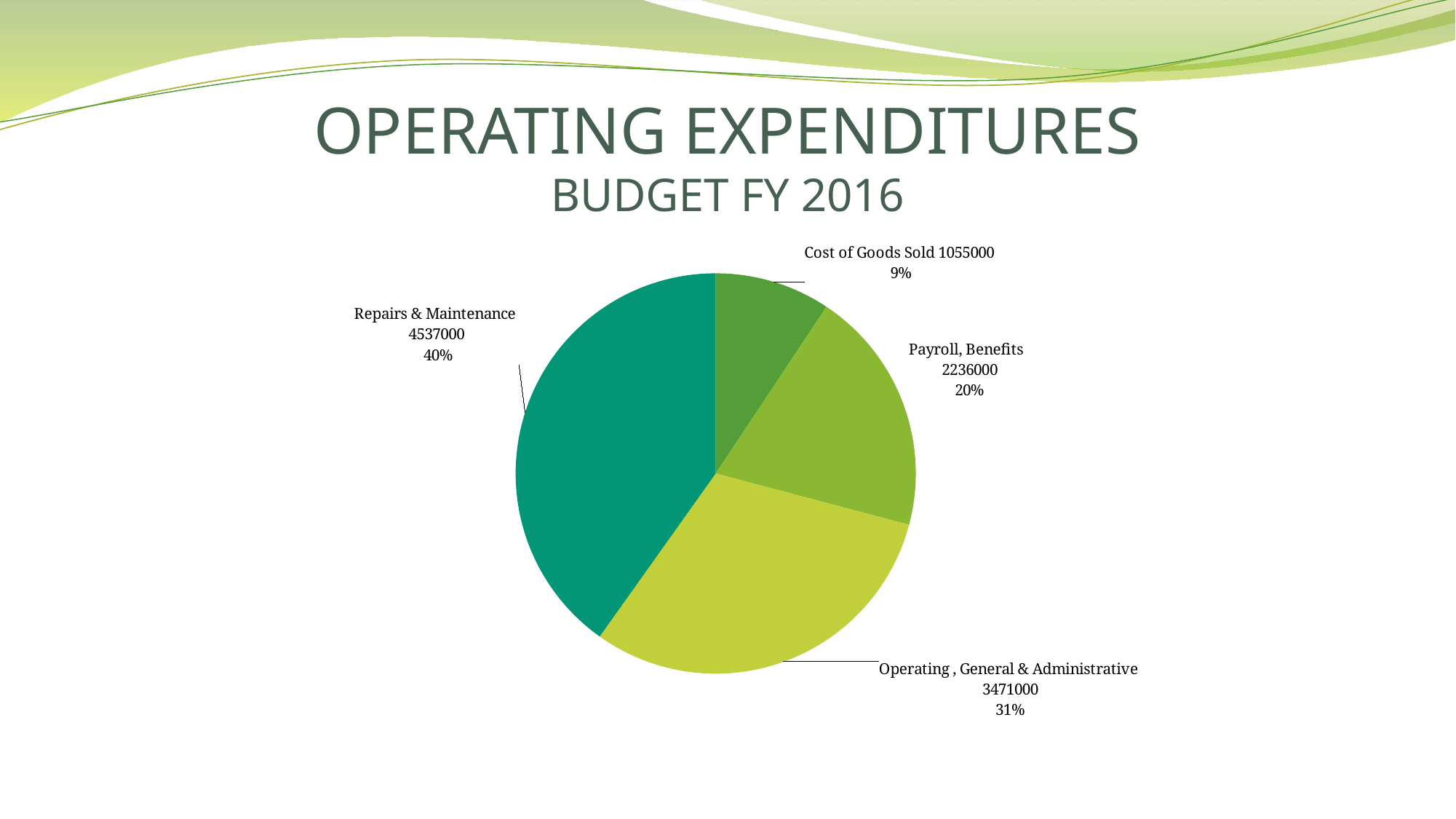
Which category has the largest slice of the pie? Repairs & Maintenance What is the value for Operating, General & Administrative? 3471000 What is the value for Payroll, Benefits? 2236000 Which is larger, the value for Payroll, Benefits or the value for Cost of Goods Sold? Payroll, Benefits What share of the pie does Payroll, Benefits represent? 20% How many categories are shown in the pie chart? 4 Which category has the smallest slice of the pie? Cost of Goods Sold What share of the pie does Operating, General & Administrative represent? 31% What is the value for Cost of Goods Sold? 1055000 What is the difference between the values for Repairs & Maintenance and Operating, General & Administrative? 1066000 What is the value for Repairs & Maintenance? 4537000 What kind of chart is shown on the slide? pie chart